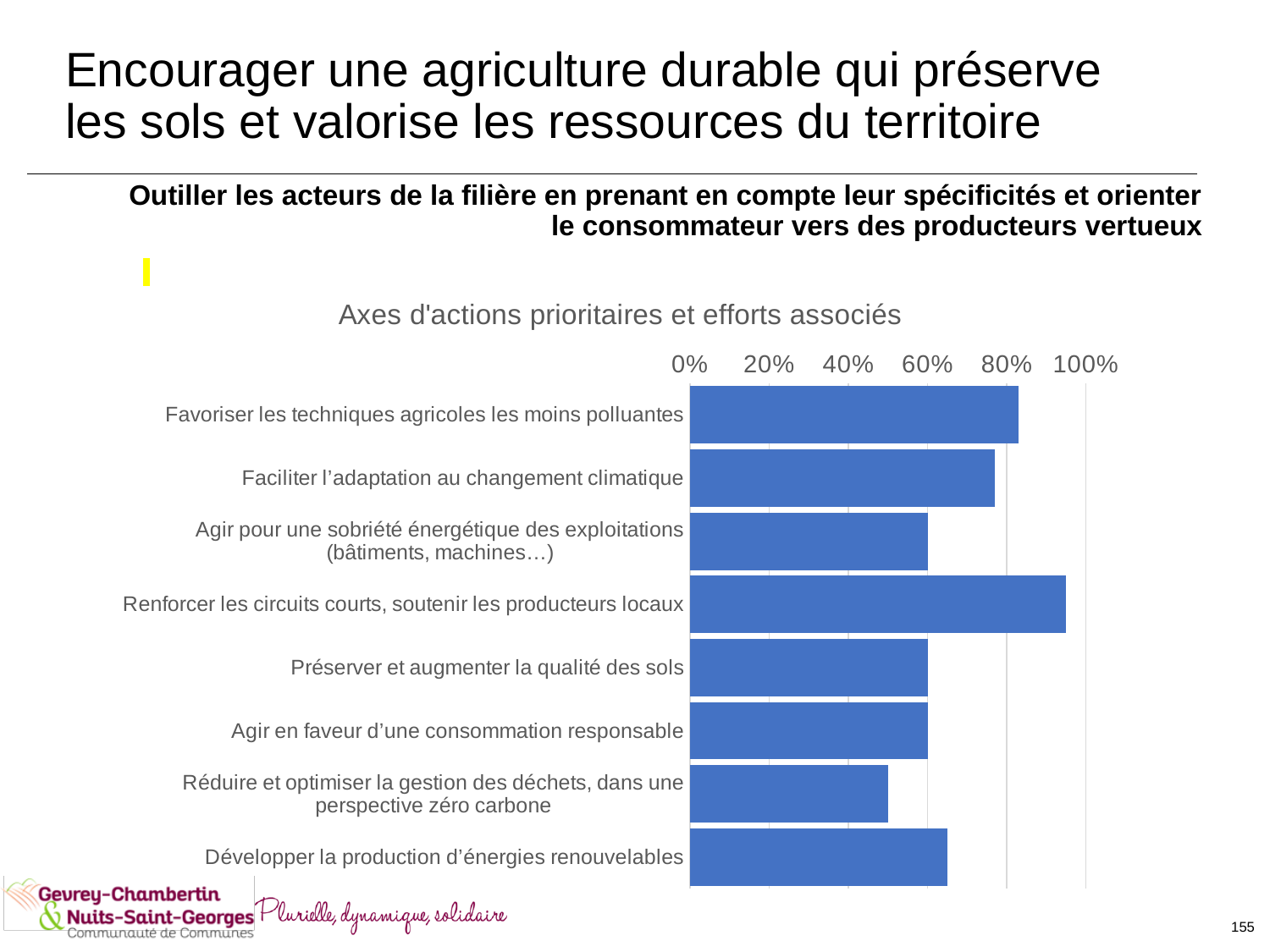
Is the value for "Développer la production d'énergies renouvelables" greater or less than 60%? greater Which category has the lowest value? Réduire et optimiser la gestion des déchets, dans une perspective zéro carbone What is the title of the chart? Axes d'actions prioritaires et efforts associés How many categories (action axes) are plotted in the chart? 8 Which is larger: the value for "Renforcer les circuits courts, soutenir les producteurs locaux" or for "Développer la production d'énergies renouvelables"? Renforcer les circuits courts, soutenir les producteurs locaux Is the value for "Réduire et optimiser la gestion des déchets, dans une perspective zéro carbone" greater or less than 60%? less Is the value for "Renforcer les circuits courts, soutenir les producteurs locaux" greater or less than 80%? greater What kind of chart is shown on the slide? Bar chart Which category has the highest value? Renforcer les circuits courts, soutenir les producteurs locaux Which is larger: the value for "Favoriser les techniques agricoles les moins polluantes" or for "Faciliter l'adaptation au changement climatique"? Favoriser les techniques agricoles les moins polluantes